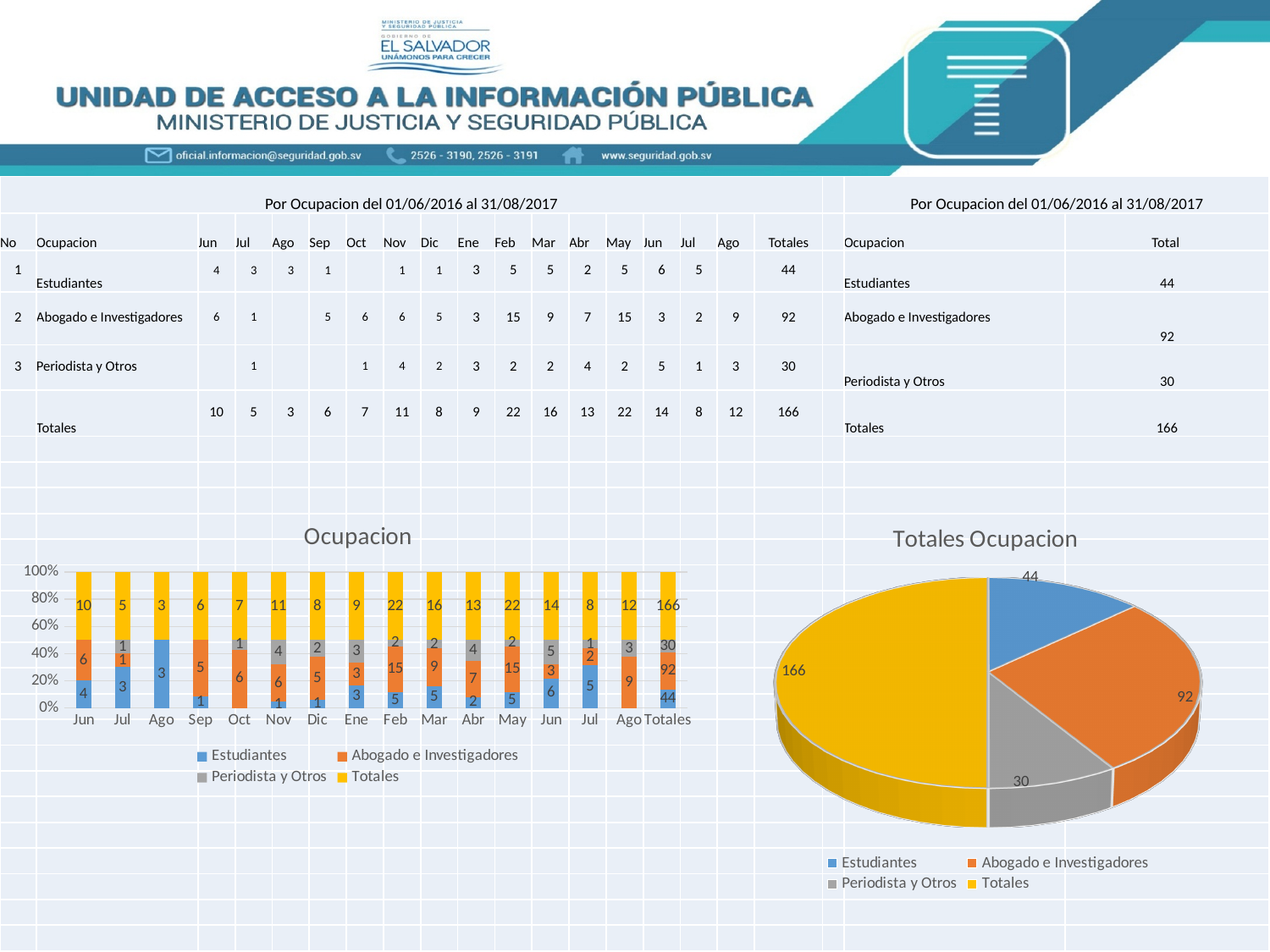
In the 'Totales Ocupacion' pie chart, what is the value for Abogado e Investigadores? 92 In the 'Ocupacion' bar chart, which is larger: the Estudiantes value for Jun (first) or the Estudiantes value for Jul (first)? Jun What type of chart is the 'Ocupacion' chart? bar chart In the 'Totales Ocupacion' pie chart, what is the difference between the Abogado e Investigadores value and the Estudiantes value? 48 In the 'Ocupacion' bar chart, what is the Totales value labelled for Feb? 22 How many categories are shown on the x axis of the 'Ocupacion' bar chart? 16 In the 'Totales Ocupacion' pie chart, which category has the smallest slice? Periodista y Otros What is the title of the bar chart on the left of the slide? Ocupacion In the 'Totales Ocupacion' pie chart, which category has the largest slice? Totales In the 'Ocupacion' bar chart, what is the Abogado e Investigadores value for Oct? 6 How many series does the legend of the 'Totales Ocupacion' chart list? 4 What type of chart is the 'Totales Ocupacion' chart? pie chart